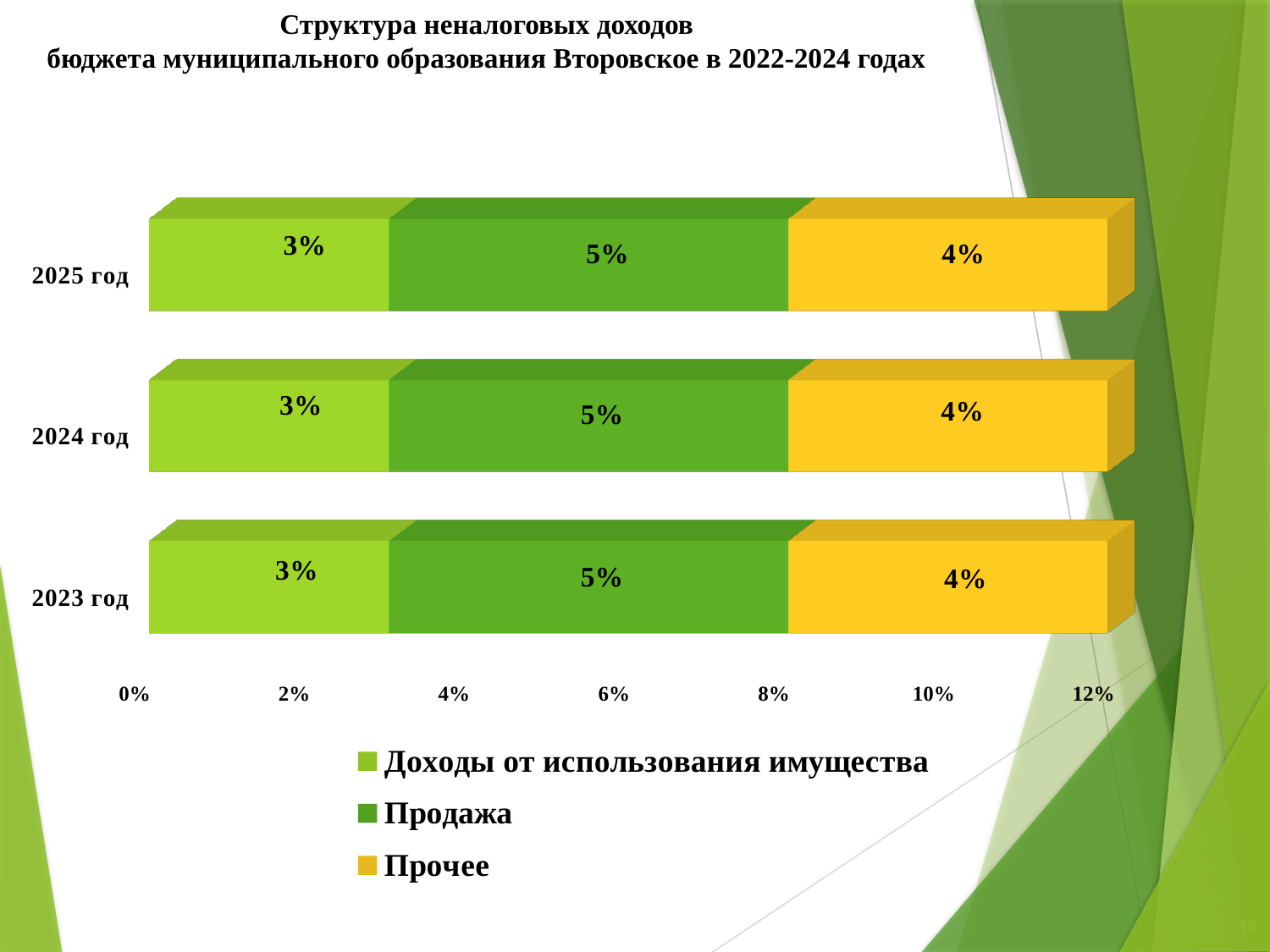
Which series has the smallest segment in the 2023 год bar? Доходы от использования имущества In 2023 год, which is larger: Продажа or Доходы от использования имущества? Продажа Does the value for Прочее rise, fall or stay the same from 2023 год to 2025 год? Stays the same What is the difference between the Продажа and Прочее values in 2024 год? 1% Which series has the largest segment in the 2025 год bar? Продажа What is the value for Прочее in 2025 год? 4% How many series does the legend list? 3 How many years (categories) are shown on the chart? 3 What is the value for Продажа in 2024 год? 5% What is the value for Доходы от использования имущества in 2023 год? 3% What type of chart is shown on the slide? Stacked bar chart What is the total of the stacked bar for 2025 год? 12%